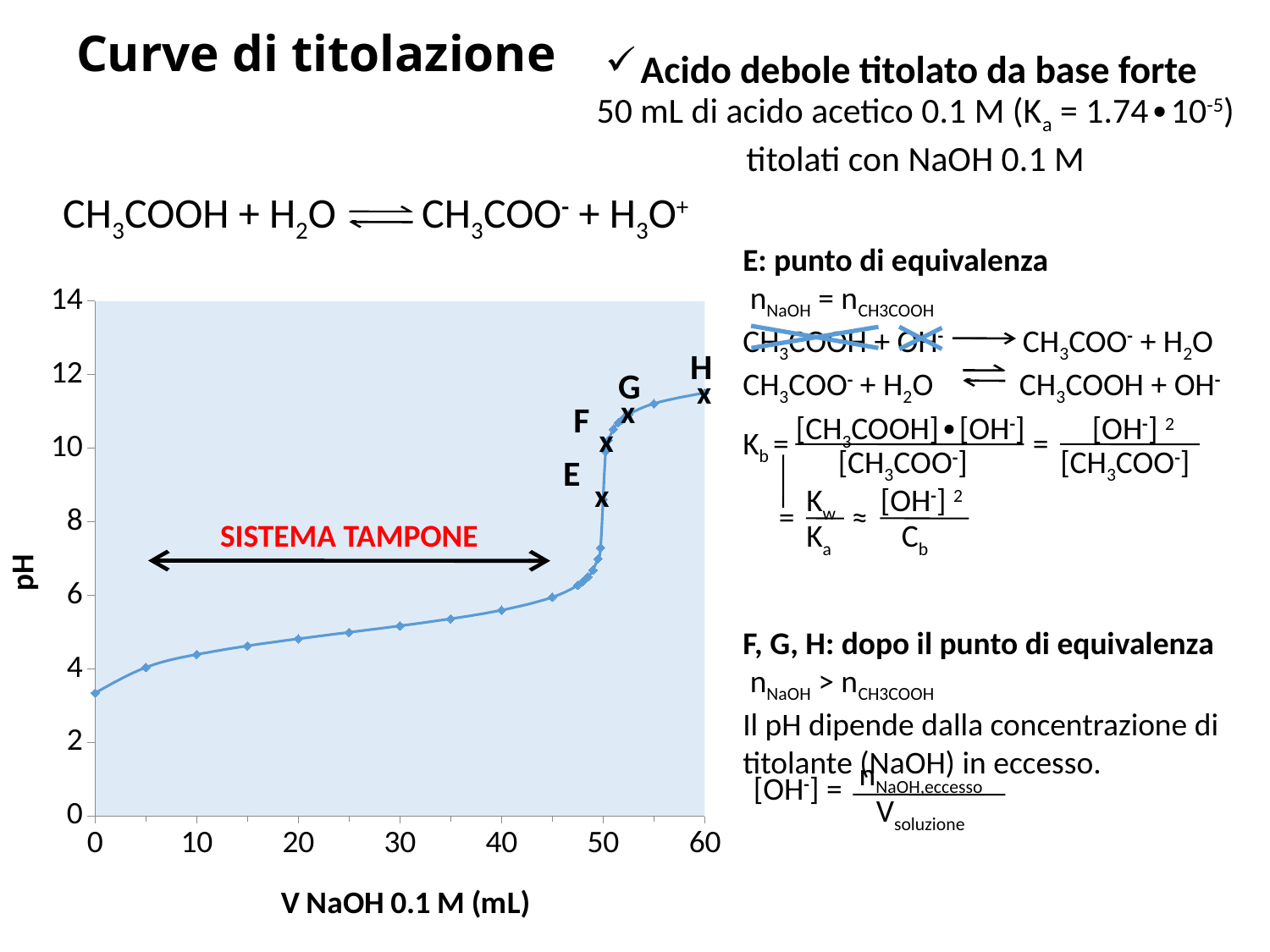
What is the label of the x axis of the chart? V NaOH 0.1 M (mL) At which volume of NaOH on the x axis is the pH highest? 60 mL What red text is written inside the chart above the double-headed arrow? SISTEMA TAMPONE What kind of chart is shown on the slide? line chart Which has the higher pH: 0 mL of NaOH or 60 mL of NaOH? 60 mL At which volume of NaOH on the x axis is the pH lowest? 0 mL Is the pH at point G greater or less than 10? greater Is the pH at 30 mL of NaOH greater or less than 6? less Does the pH rise or fall as the volume of NaOH increases along the x axis? rises Is the pH at 0 mL of NaOH greater or less than 4? less